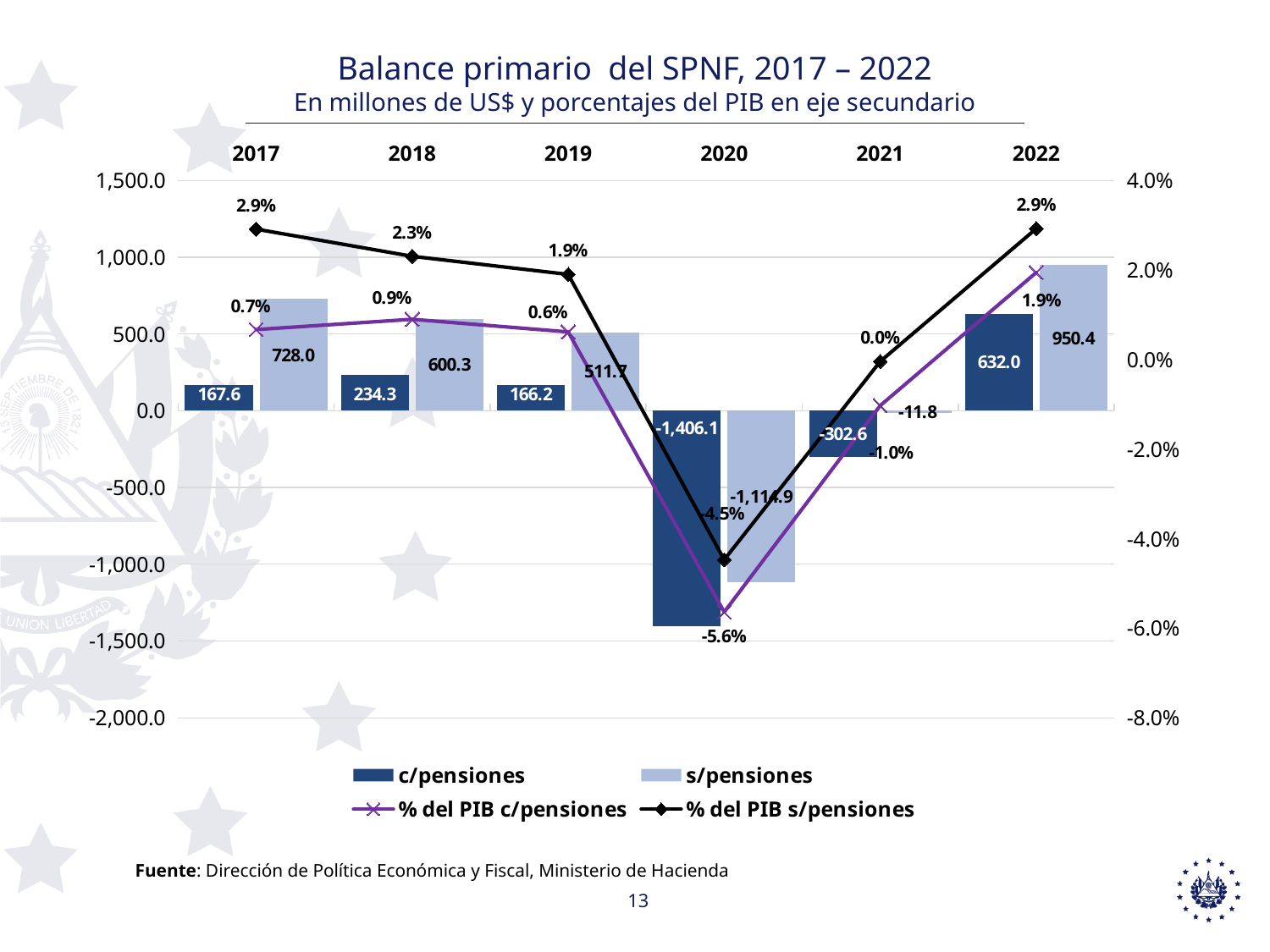
What is the value of s/pensiones for 2022? 950.4 What is the difference between the s/pensiones values for 2017 and 2018? 127.7 What is the value of c/pensiones for 2020? -1,406.1 How many series does the legend list? 4 In which year is the s/pensiones bar highest? 2022 How many years are shown on the x axis? 6 What is the % del PIB c/pensiones value for 2021? -1.0% In which year is the c/pensiones bar lowest? 2020 In 2019, which is larger: c/pensiones or s/pensiones? s/pensiones Does the % del PIB s/pensiones line rise or fall from 2017 to 2019? fall What is the % del PIB s/pensiones value for 2018? 2.3% What is the difference between the c/pensiones values for 2022 and 2018? 397.7